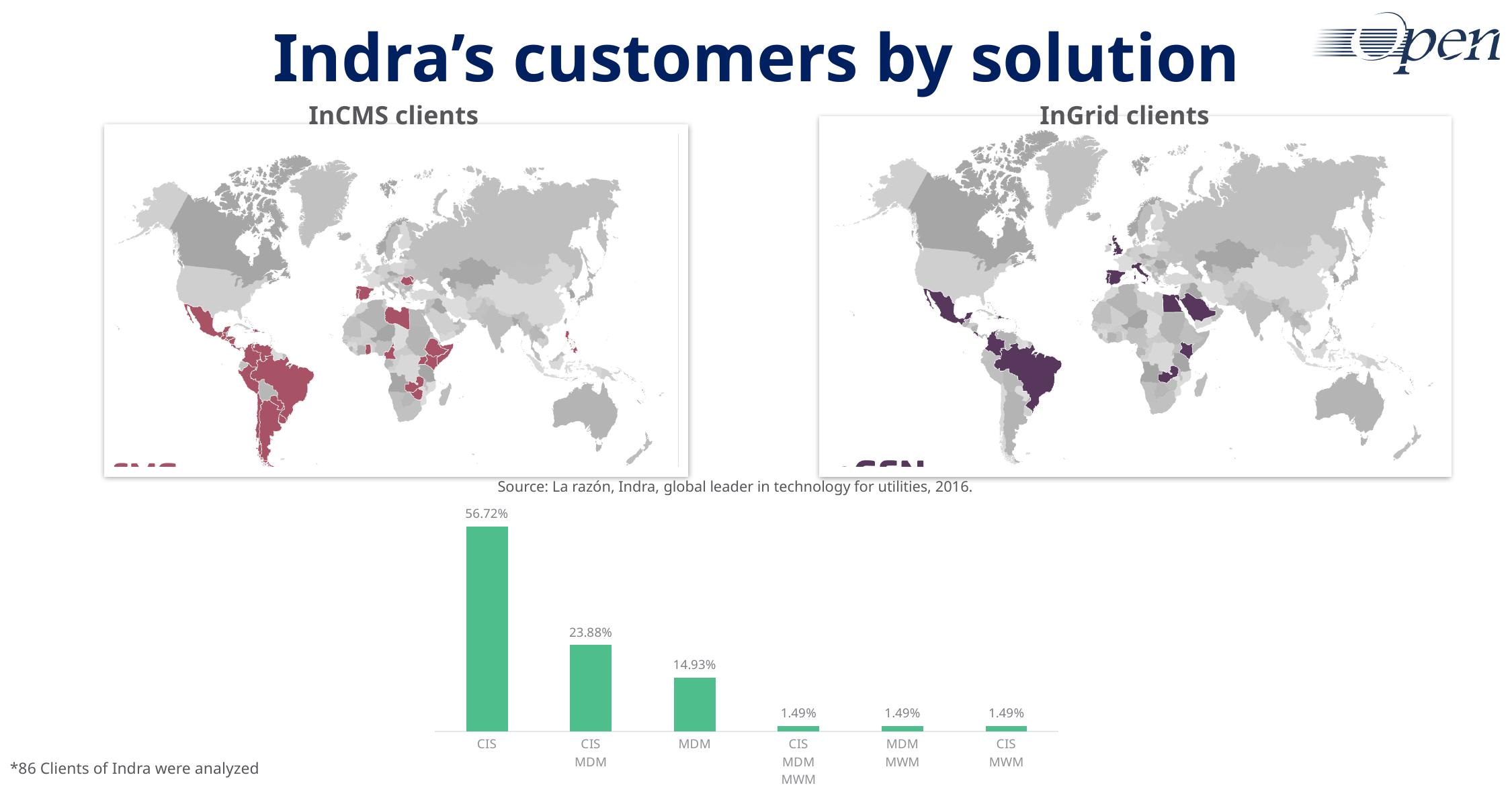
In the bar chart at the bottom of the slide, what is the value for MDM MWM? 1.49% In the bar chart at the bottom of the slide, which is larger, the value for MDM or the value for CIS MWM? MDM In the bar chart at the bottom of the slide, what is the value for CIS MDM? 23.88% In the bar chart at the bottom of the slide, what is the value for CIS? 56.72% What kind of chart is shown at the bottom of the slide? Bar chart In the bar chart at the bottom of the slide, what is the lowest value shown? 1.49% In the bar chart at the bottom of the slide, what is the value for MDM? 14.93% In the bar chart at the bottom of the slide, which category has the highest value? CIS In the bar chart at the bottom of the slide, what is the difference between the values for CIS MDM and MDM? 8.95% In the bar chart at the bottom of the slide, what is the difference between the values for CIS and CIS MDM? 32.84% In the bar chart at the bottom of the slide, do the values rise or fall from left to right? Fall How many categories are shown in the bar chart at the bottom of the slide? 6